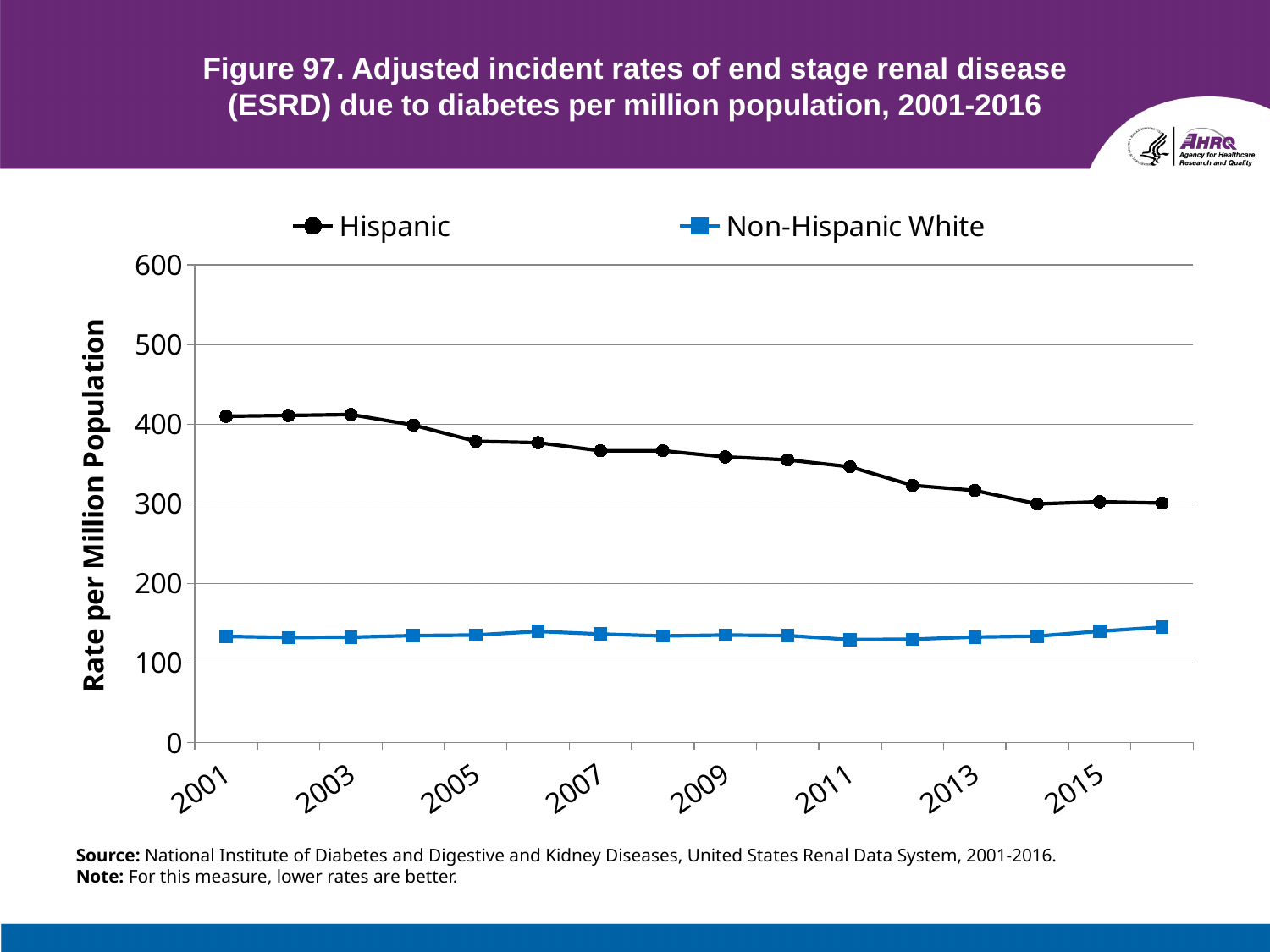
Is the Hispanic value for 2005 greater or less than 400? less How many series does the legend list? 2 Does the Hispanic rate rise or fall from 2001 to 2016? fall Is the Hispanic value for 2001 greater or less than 400? greater What is the label on the vertical axis? Rate per Million Population Is the Non-Hispanic White value for 2001 greater or less than 200? less What kind of chart is shown on the slide? line chart How many years are plotted for each series? 16 Which two groups are shown in the legend? Hispanic and Non-Hispanic White In 2016, which group has the higher rate, Hispanic or Non-Hispanic White? Hispanic